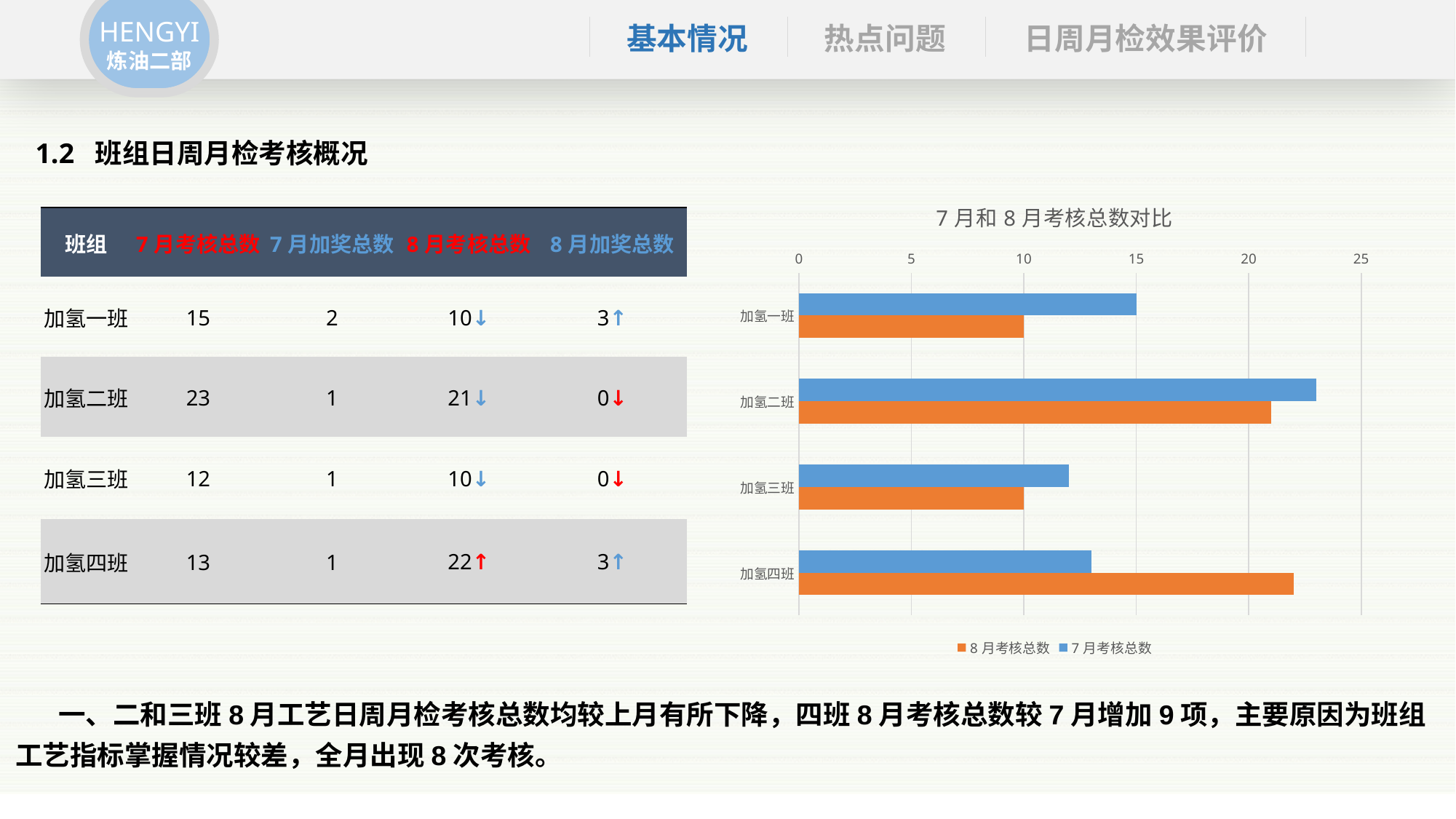
What is the title of the chart? 7月和8月考核总数对比 What kind of chart is shown on the slide? bar chart How many series does the chart legend list? 2 Which 班组 has the highest 7月考核总数 in the chart? 加氢二班 What is the difference between the 7月考核总数 and 8月考核总数 values for 加氢一班? 5 What is the 7月考核总数 value for 加氢一班 in the chart? 15 What is the 8月考核总数 value for 加氢三班 in the chart? 10 Is the 7月考核总数 value for 加氢二班 greater or less than 20? greater What is the 8月考核总数 value for 加氢一班 in the chart? 10 For 加氢四班, which is larger in the chart: 7月考核总数 or 8月考核总数? 8月考核总数 How many 班组 categories are plotted in the chart? 4 Which colour represents 8月考核总数 in the chart? orange